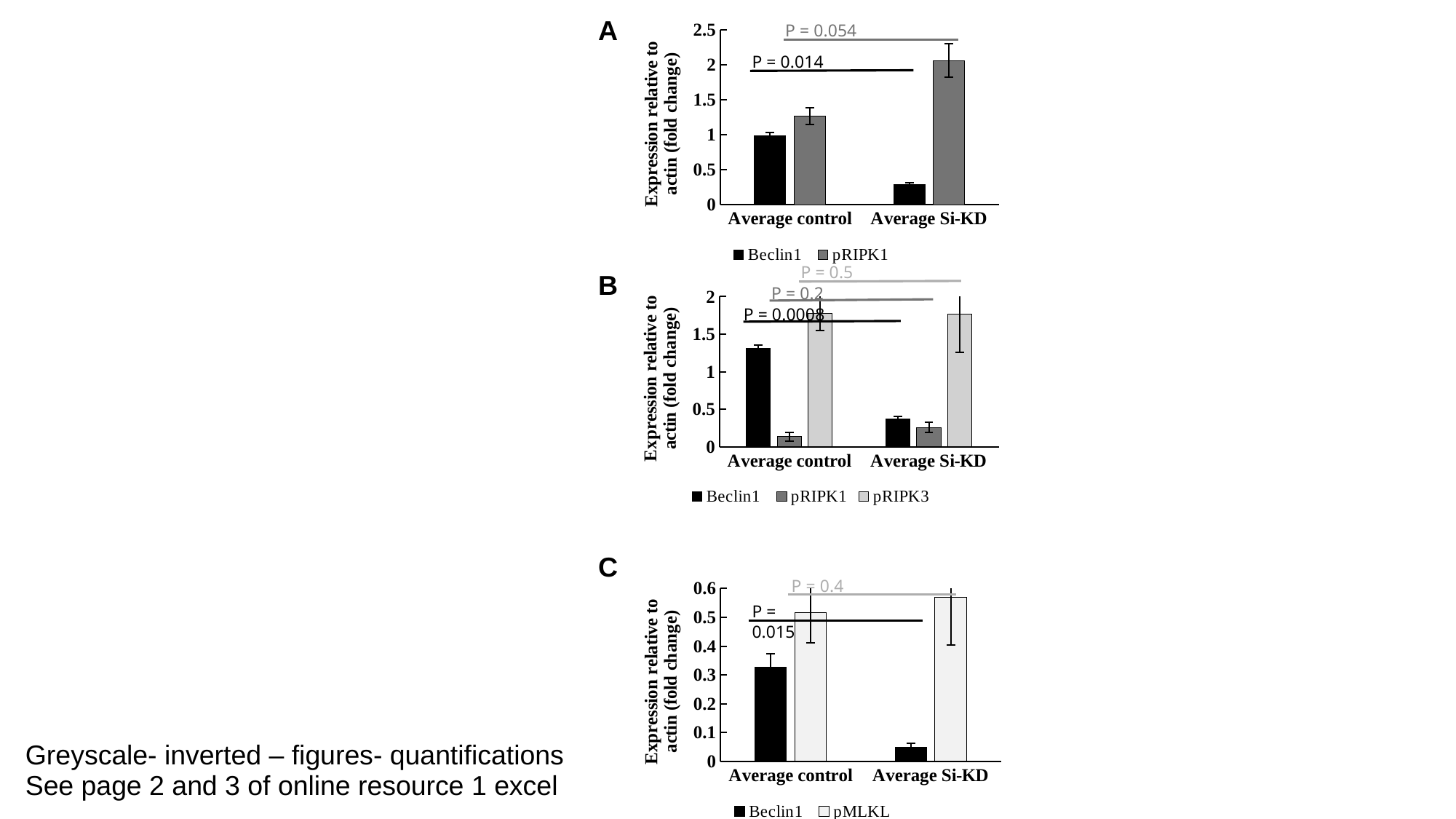
In chart B, is the value for Beclin1 in Average control greater or less than 1? greater In chart C, is the value for Beclin1 in Average Si-KD greater or less than 0.1? less In chart C, what kind of chart is shown? bar chart In chart C, what P value is shown for the Beclin1 comparison between Average control and Average Si-KD? P = 0.015 In chart B, which series has the highest value in Average Si-KD? pRIPK3 In chart C, which is larger for Average control: Beclin1 or pMLKL? pMLKL In chart A, which is larger for Average control: Beclin1 or pRIPK1? pRIPK1 In chart A, how many series does the legend list? 2 In chart A, is the value for Beclin1 in Average Si-KD greater or less than 0.5? less In chart B, how many series does the legend list? 3 In chart B, which series has the lowest value in Average control? pRIPK1